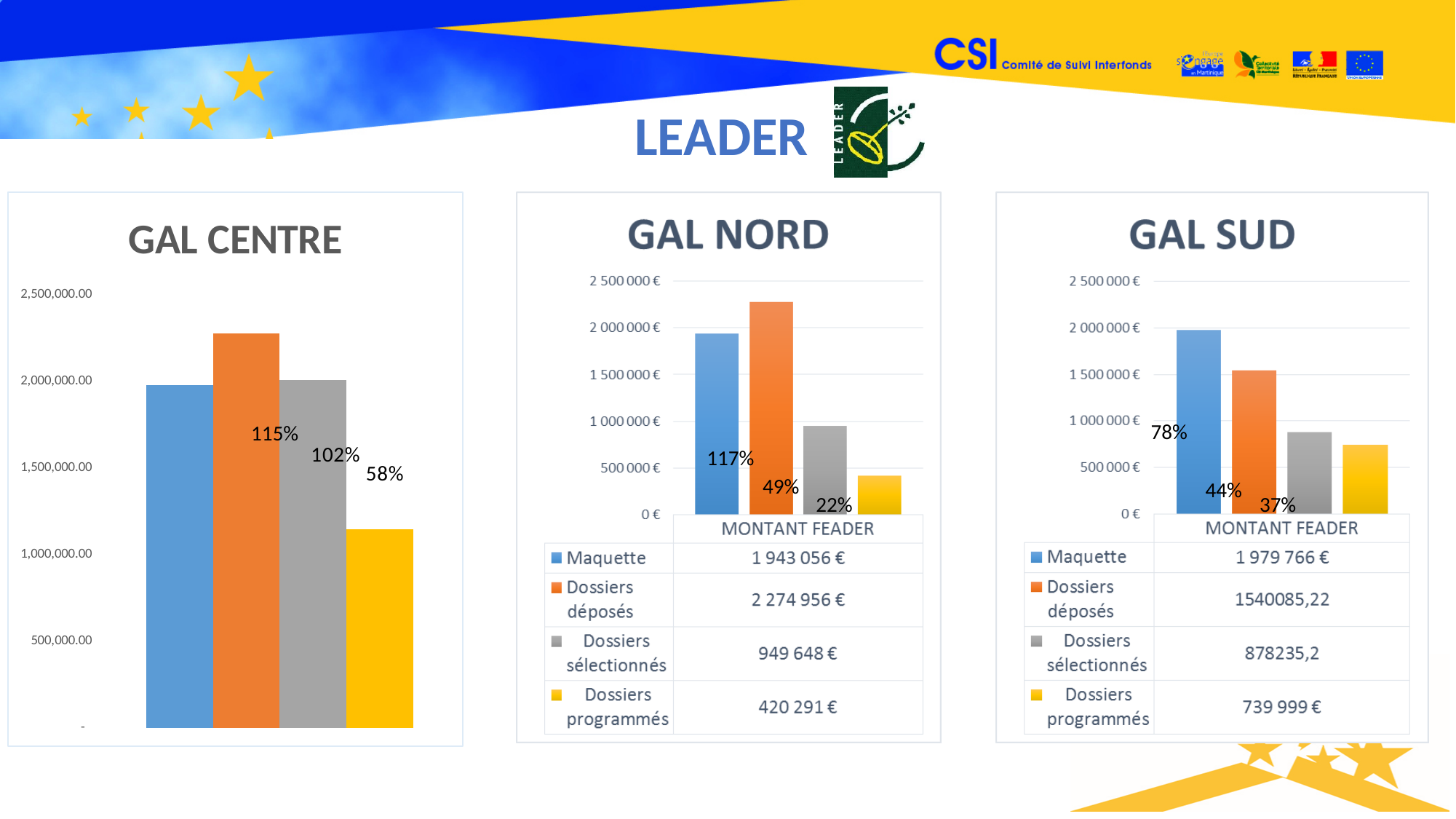
In the GAL SUD chart, what is the value for Dossiers sélectionnés? 878235,2 In the GAL NORD chart, what is the value for Dossiers programmés? 420 291 € In the GAL SUD chart, which is larger: Dossiers sélectionnés or Dossiers programmés? Dossiers sélectionnés In the GAL NORD chart, which category has the lowest value? Dossiers programmés In the GAL SUD chart, what is the value for Dossiers déposés? 1540085,22 In the GAL NORD chart, what is the MONTANT FEADER value for Maquette? 1 943 056 € In the GAL CENTRE chart, is the value of the yellow bar greater or less than 1,500,000.00? less In the GAL SUD chart, which category has the highest value? Maquette How many bars are plotted in the GAL CENTRE chart? 4 In the GAL NORD chart, which category has the highest value? Dossiers déposés In the GAL SUD chart, what is the difference between Maquette and Dossiers programmés? 1 239 767 € In the GAL NORD chart, what is the difference between Dossiers déposés and Maquette? 331 900 €